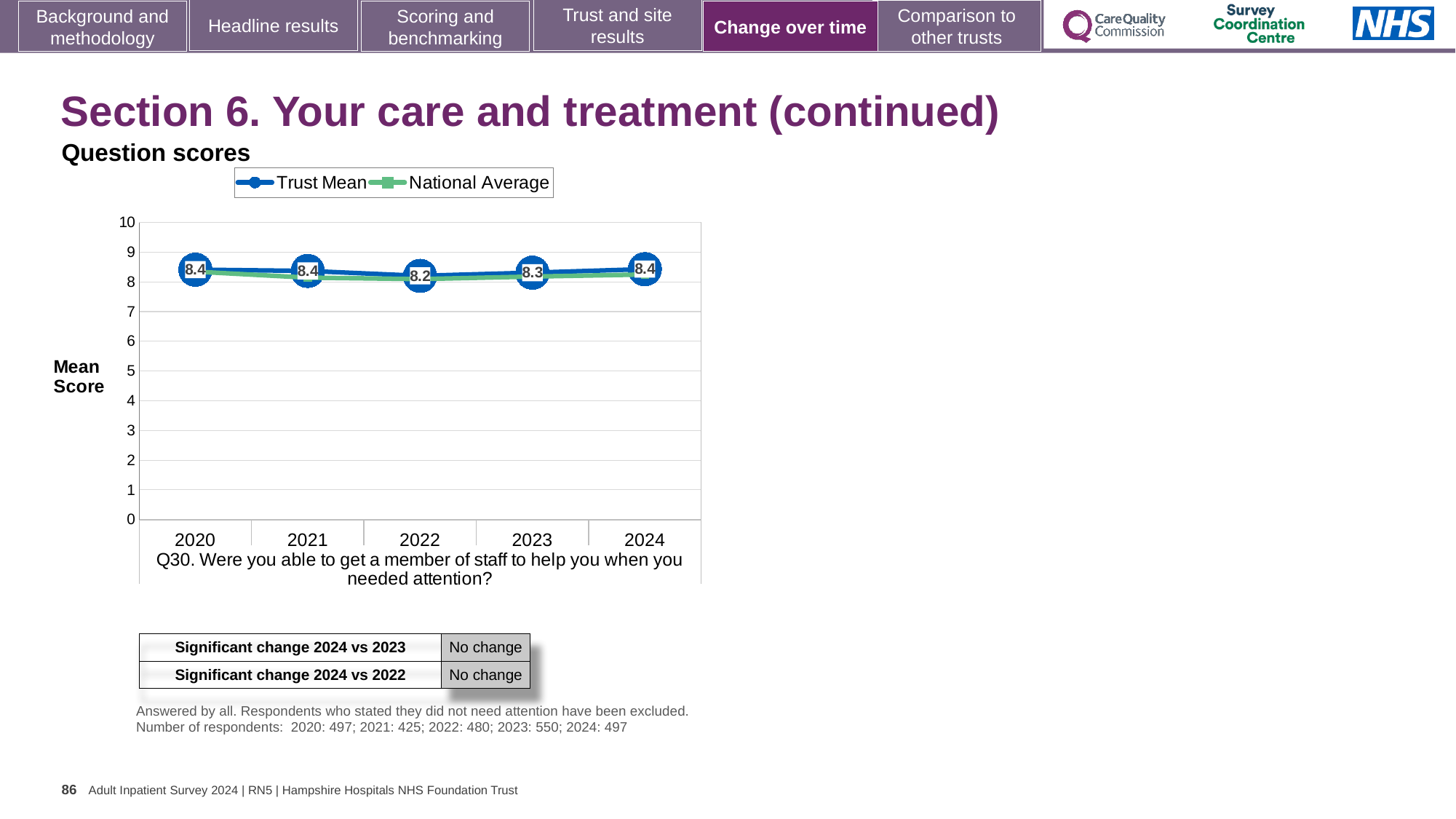
What is the Trust Mean value for 2024? 8.4 Does the Trust Mean rise or fall from 2022 to 2024? rise What is the difference between the Trust Mean in 2020 and in 2022? 0.2 In which year is the Trust Mean lowest? 2022 Which year has the larger Trust Mean, 2021 or 2022? 2021 How many series does the legend list? 2 What is the Trust Mean value for 2020? 8.4 Is the National Average value for 2024 greater or less than 5? greater How many years are plotted on the x axis? 5 What is the Trust Mean value for 2022? 8.2 What is the Trust Mean value for 2023? 8.3 What kind of chart is shown? line chart